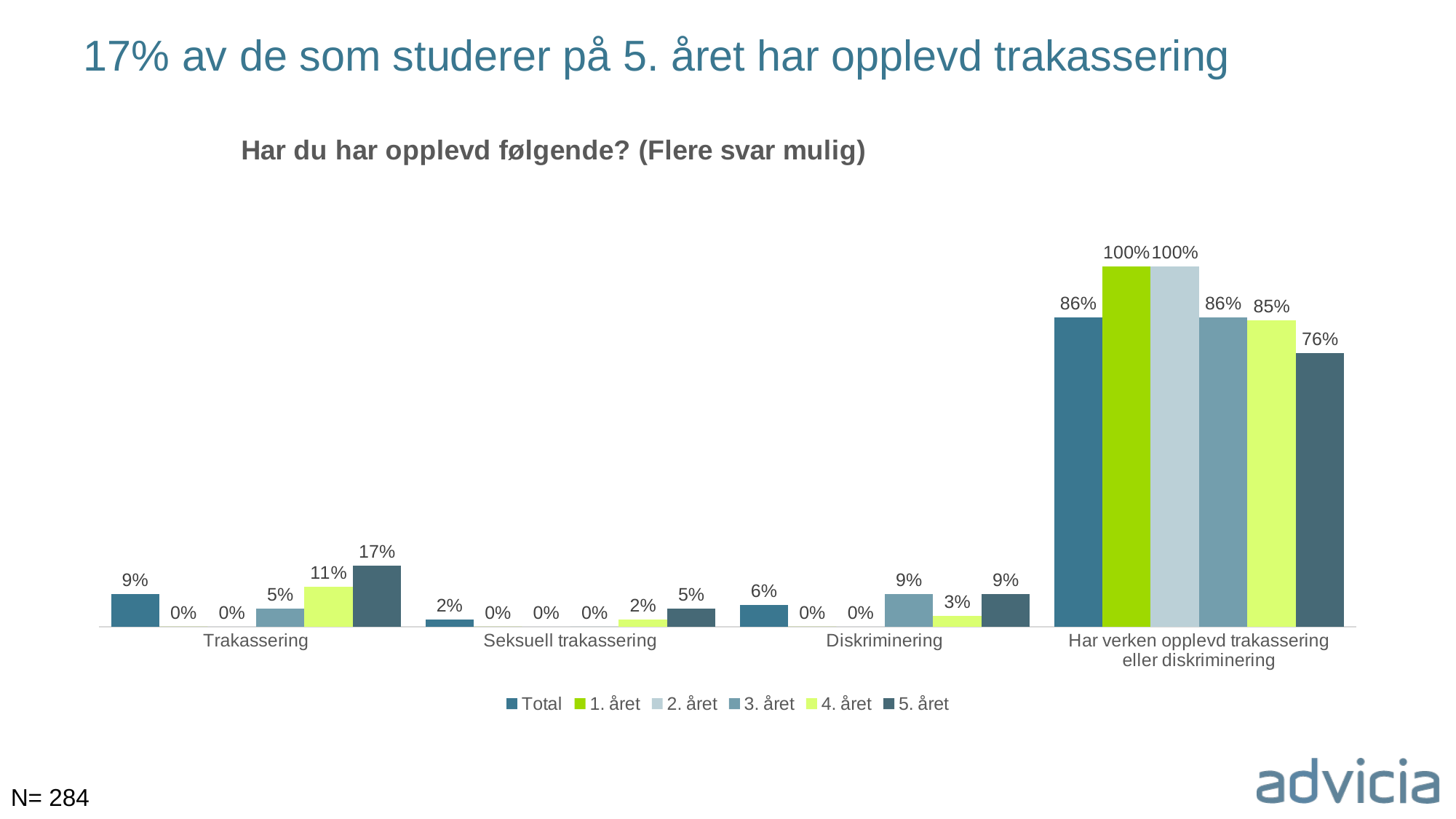
Which series has the highest value in the Trakassering category? 5. året What is the value for 4. året in the 'Har verken opplevd trakassering eller diskriminering' category? 85% What kind of chart is shown on the slide? Bar chart What is the value for 3. året in the Seksuell trakassering category? 0% How many series does the legend list? 6 Which series has the lowest value in the 'Har verken opplevd trakassering eller diskriminering' category? 5. året What is the Total value for Diskriminering? 6% Which is larger for Diskriminering: the value for 3. året or the value for 4. året? 3. året What is the difference between the 5. året and Total values for Trakassering? 8 percentage points What is the value for 5. året in the Trakassering category? 17% How many categories are shown on the x axis? 4 What is the title of the chart? Har du har opplevd følgende? (Flere svar mulig)